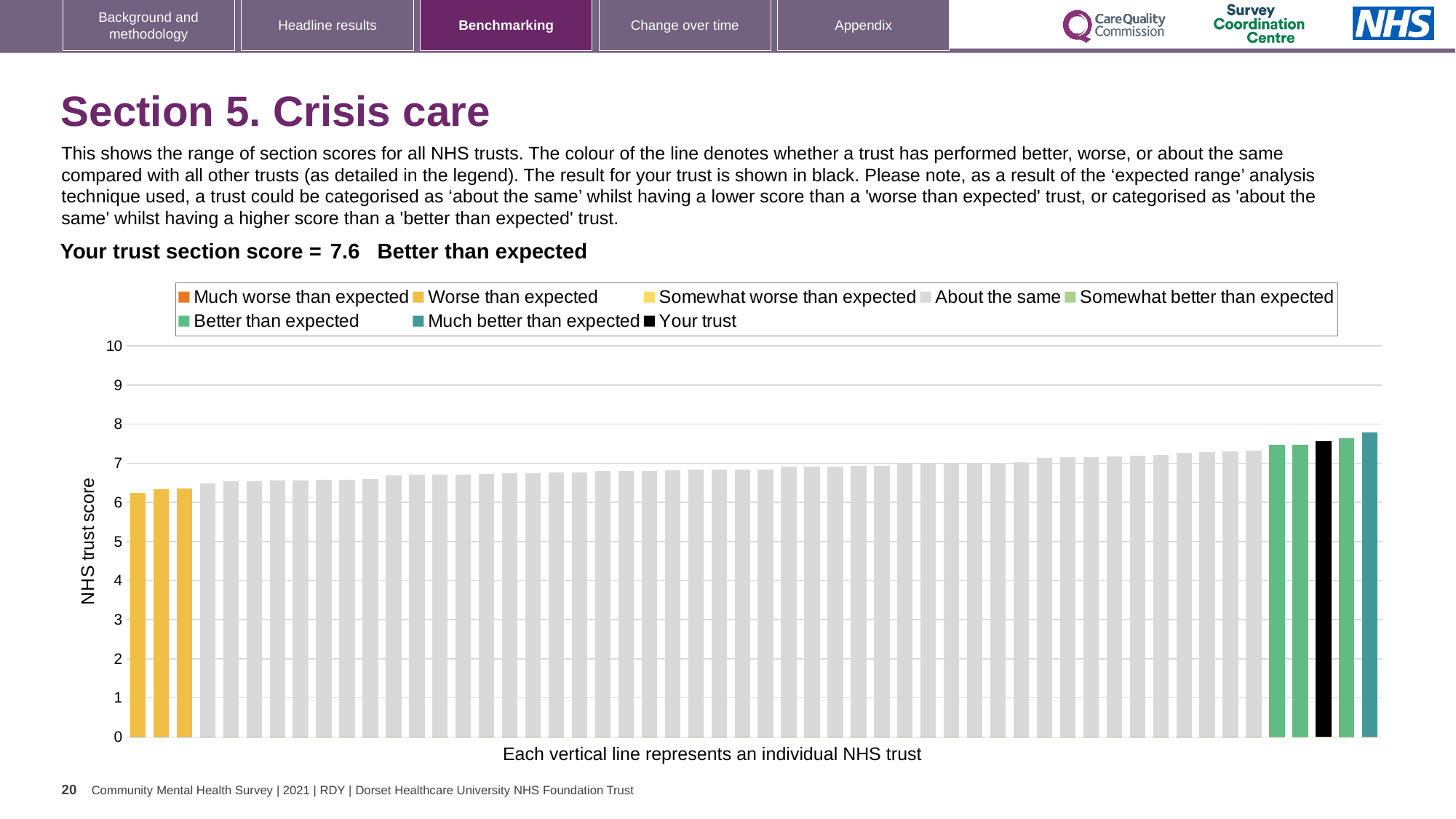
Which is larger: the value for your trust (black bar) or the value of the leftmost bar? your trust What is the section score for your trust shown on the slide? 7.6 How many entries does the chart legend list? 8 Is the value for your trust (the black bar) greater or less than 7? greater Is the value of the leftmost bar greater or less than 7? less What is the title of the vertical axis? NHS trust score Which legend category does the highest bar on the chart belong to? Much better than expected How many bars are coloured as 'Worse than expected' (yellow)? 3 Which performance category is your trust placed in for crisis care? Better than expected Is the value of the rightmost bar greater or less than 8? less What kind of chart is shown on the slide? bar chart Do the bar values rise or fall from left to right along the x axis? rise